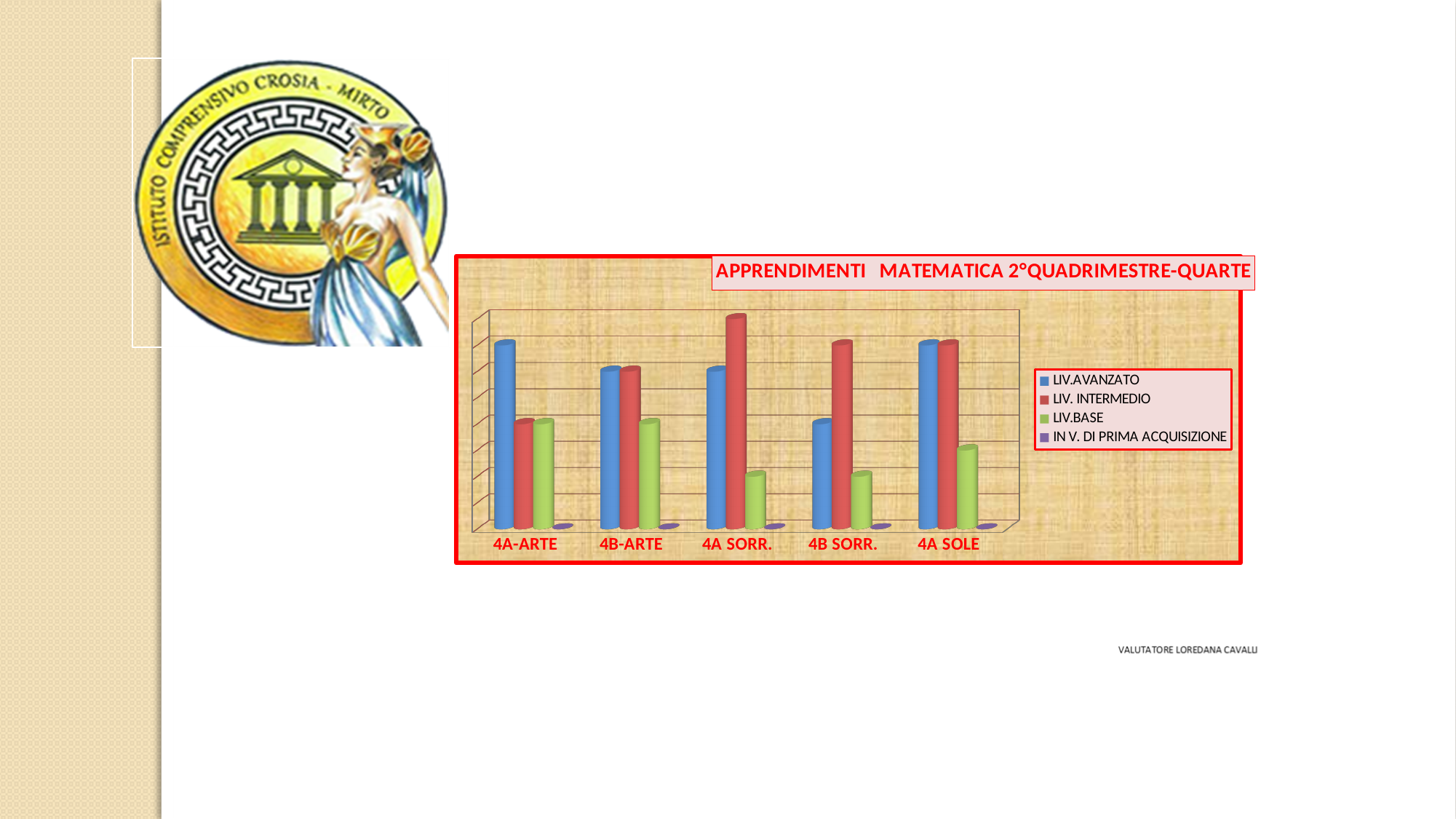
For 4A-ARTE, which is larger: LIV.AVANZATO or LIV. INTERMEDIO? LIV.AVANZATO What kind of chart is shown on the slide? bar chart Which series is shown in green in the chart? LIV.BASE For 4B SORR., which is larger: LIV.AVANZATO or LIV. INTERMEDIO? LIV. INTERMEDIO For 4A SOLE, which is larger: LIV.AVANZATO or LIV.BASE? LIV.AVANZATO What is the title of the chart? APPRENDIMENTI MATEMATICA 2°QUADRIMESTRE-QUARTE Which class has the highest LIV. INTERMEDIO bar? 4A SORR. Which class has the lowest LIV.AVANZATO bar? 4B SORR. Which class has the lowest LIV. INTERMEDIO bar? 4A-ARTE How many series does the chart's legend list? 4 How many classes (categories) are shown on the x axis of the chart? 5